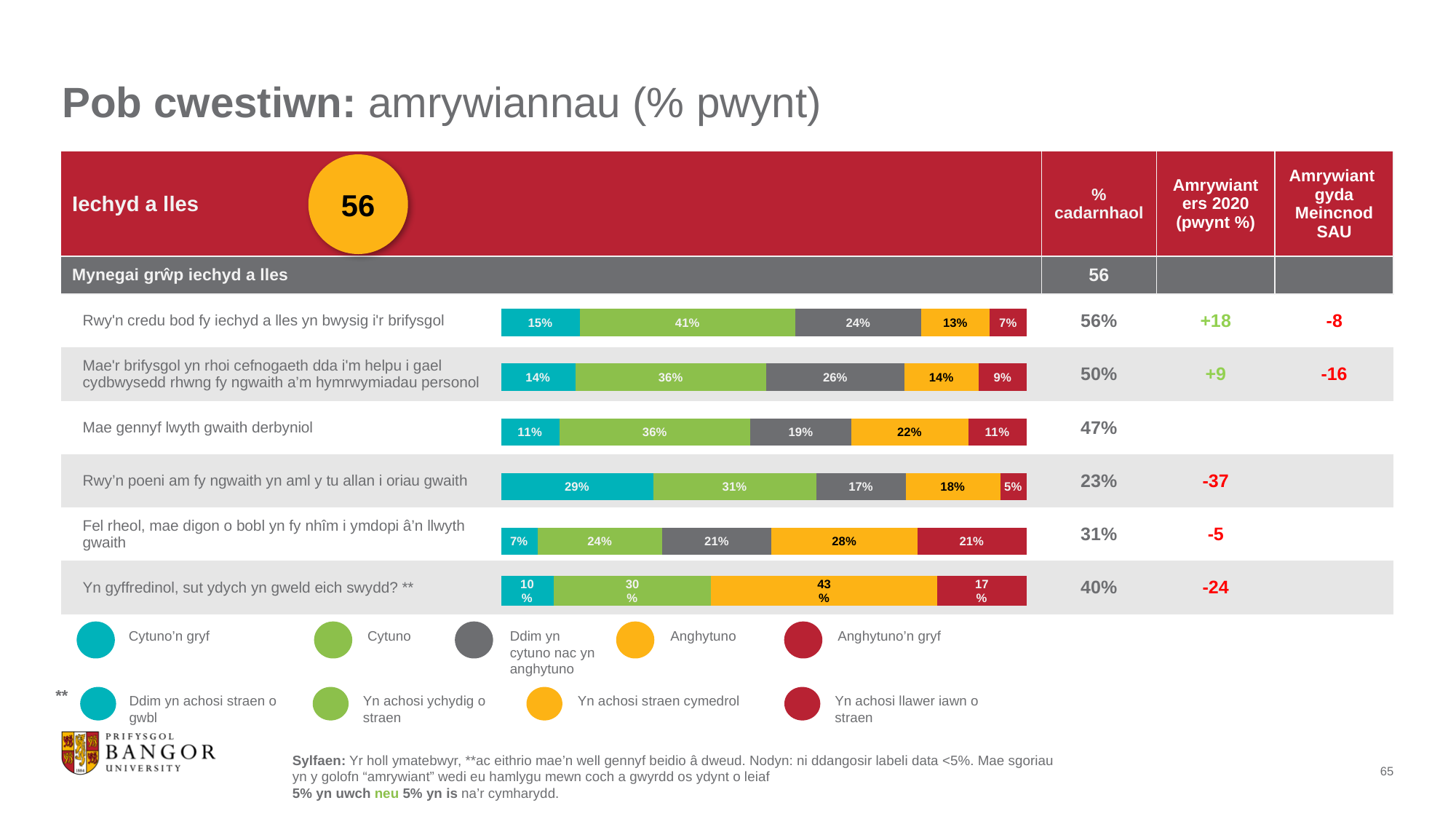
How many response categories does the main legend (Cytuno'n gryf to Anghytuno'n gryf) list? 5 What is the 'Cytuno' percentage for 'Mae gennyf lwyth gwaith derbyniol'? 36% What is the 'Cytuno'n gryf' percentage for 'Rwy'n credu bod fy iechyd a lles yn bwysig i'r brifysgol'? 15% Which statement has the highest 'Cytuno'n gryf' percentage? Rwy'n poeni am fy ngwaith yn aml y tu allan i oriau gwaith Which is larger for 'Mae'r brifysgol yn rhoi cefnogaeth dda i'm helpu i gael cydbwysedd rhwng fy ngwaith a'm hymrwymiadau personol': the 'Cytuno' segment or the 'Ddim yn cytuno nac yn anghytuno' segment? Cytuno How many statements (bars) are shown in the chart? 6 What is the combined total of the 'Cytuno'n gryf' and 'Cytuno' segments for 'Rwy'n poeni am fy ngwaith yn aml y tu allan i oriau gwaith'? 60% What is the difference between the 'Cytuno' percentage and the 'Anghytuno' percentage for 'Rwy'n credu bod fy iechyd a lles yn bwysig i'r brifysgol'? 28% What type of chart is used to show the response breakdown for each statement? Stacked bar chart Which statement has the lowest 'Cytuno'n gryf' percentage? Fel rheol, mae digon o bobl yn fy nhîm i ymdopi â'n llwyth gwaith What is the 'Anghytuno' percentage for 'Fel rheol, mae digon o bobl yn fy nhîm i ymdopi â'n llwyth gwaith'? 28% What colour represents 'Anghytuno'n gryf' in the legend? Red